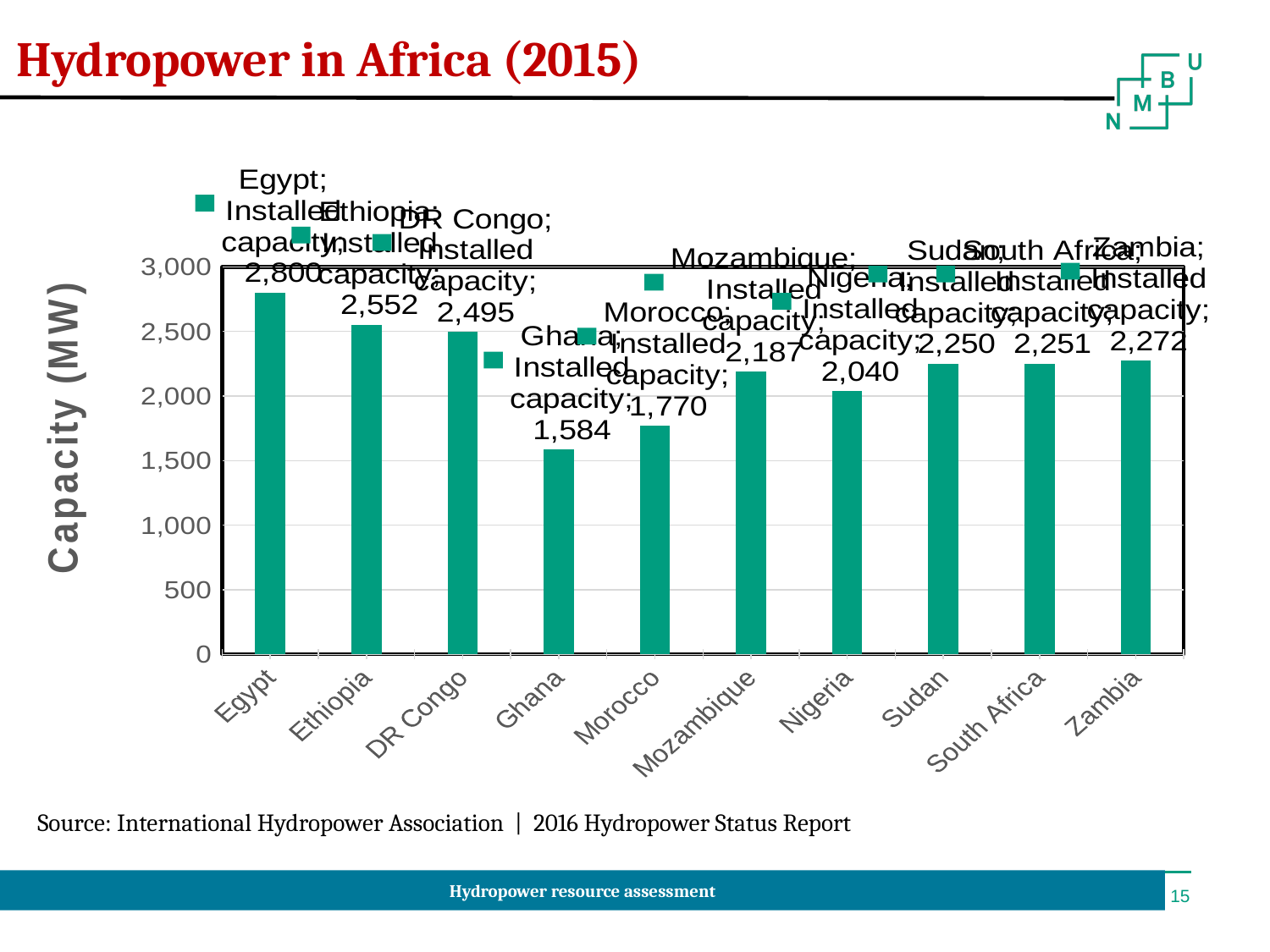
Which has a larger installed capacity, Morocco or Nigeria? Nigeria What is the label of the vertical axis? Capacity (MW) What is the installed capacity value shown for Zambia? 2,272 What is the installed capacity value shown for Ghana? 1,584 Which country has the highest installed capacity in the chart? Egypt Is the value for DR Congo greater or less than 2,000? greater What is the difference between the installed capacity of Egypt and Ethiopia? 248 Which country has the lowest installed capacity in the chart? Ghana How many countries are shown in the chart? 10 What is the installed hydropower capacity shown for Egypt? 2,800 What type of chart is shown on the slide? Bar chart What is the installed capacity value shown for Mozambique? 2,187